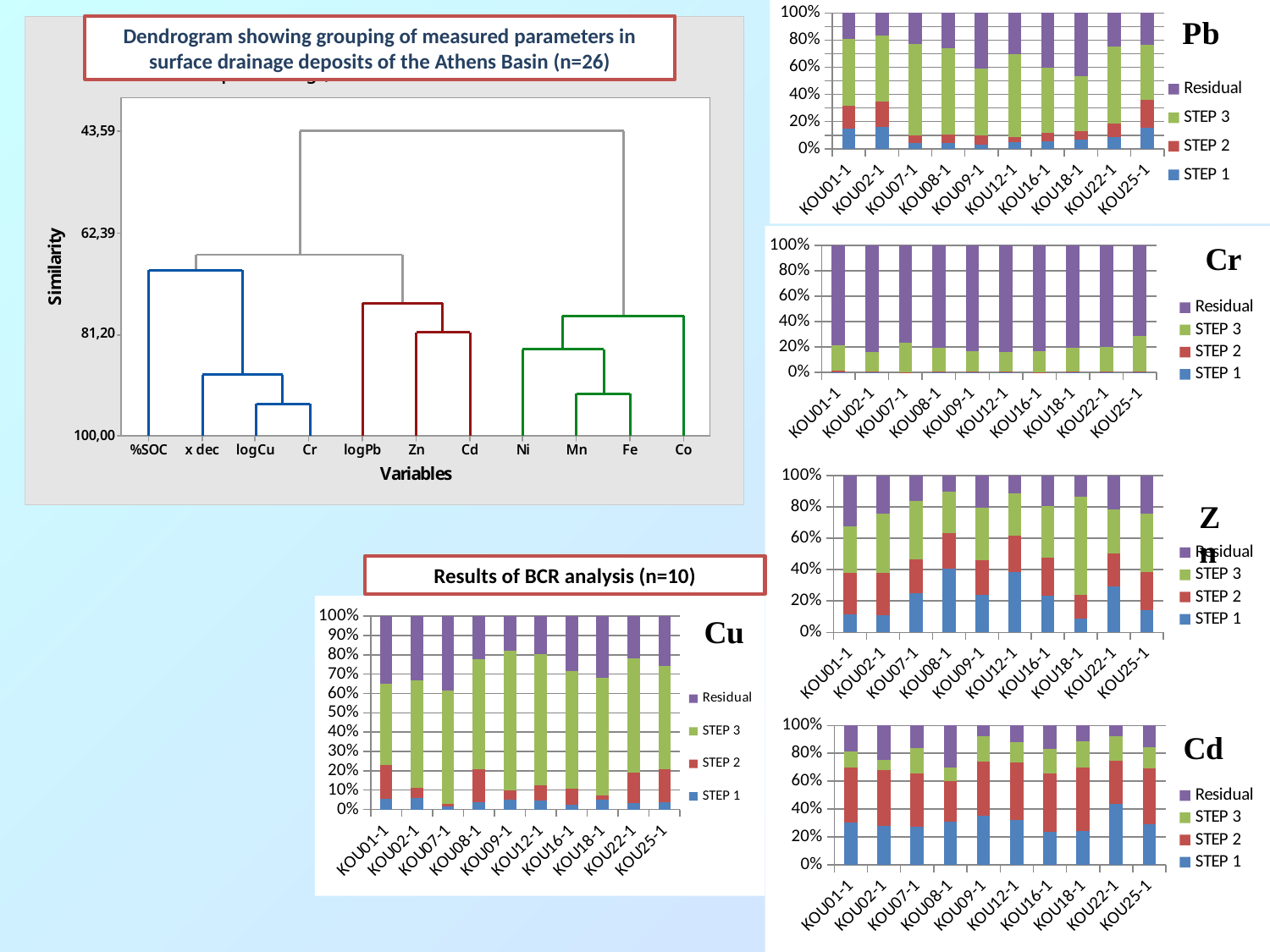
What kind of chart is the Pb chart on the slide? stacked bar chart In the Cd chart, which sample has the largest STEP 1 share? KOU22-1 In the Cr chart, is the Residual share for KOU01-1 greater or less than 60%? greater How many sample categories are shown on the x axis of the Cd chart? 10 How many variables are listed along the x axis of the dendrogram? 11 What is the label of the y axis of the dendrogram? Similarity In the Zn chart, is the STEP 1 share for KOU08-1 greater or less than 20%? greater In the Cd chart, is the STEP 1 share for KOU09-1 greater or less than 20%? greater What is the total of the stacked bar for KOU01-1 in the Pb chart? 100% What is the title of the box above the five stacked bar charts? Results of BCR analysis (n=10) How many series does the legend of the Cu chart list? 4